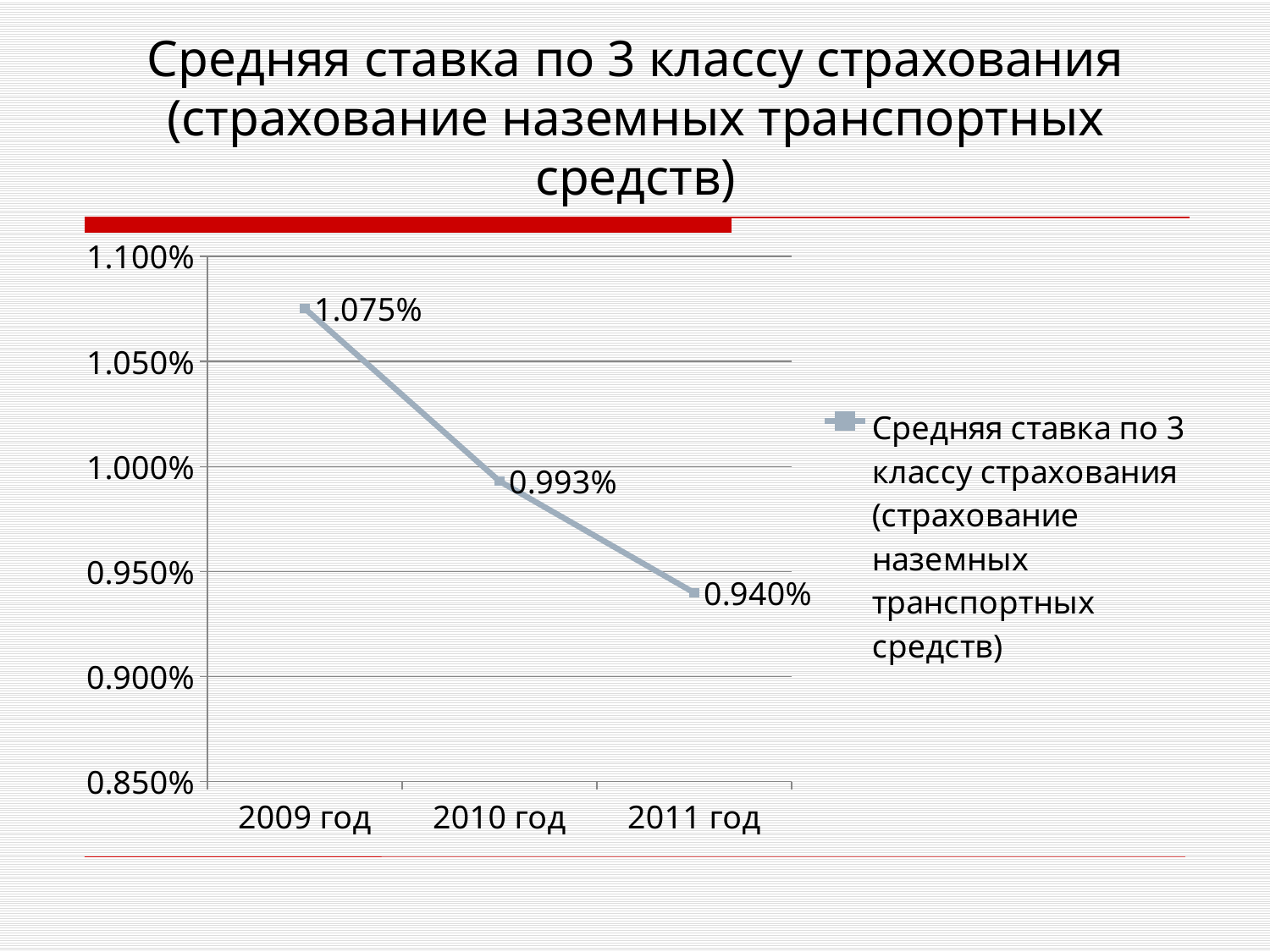
Which year has the lowest average rate? 2011 год Is the value for 2010 год greater or less than 1.000%? less Do the values rise or fall from 2009 год to 2011 год? fall What is the average rate for 2010 год? 0.993% What is the average rate for 2011 год? 0.940% What is the difference between the rate in 2009 год and the rate in 2011 год? 0.135% Which year has the highest average rate? 2009 год What is the difference between the rate in 2009 год and the rate in 2010 год? 0.082% Which is larger, the rate in 2010 год or the rate in 2011 год? 2010 год What kind of chart is shown on the slide? line chart How many years are plotted on the chart? 3 What is the average rate for 2009 год? 1.075%